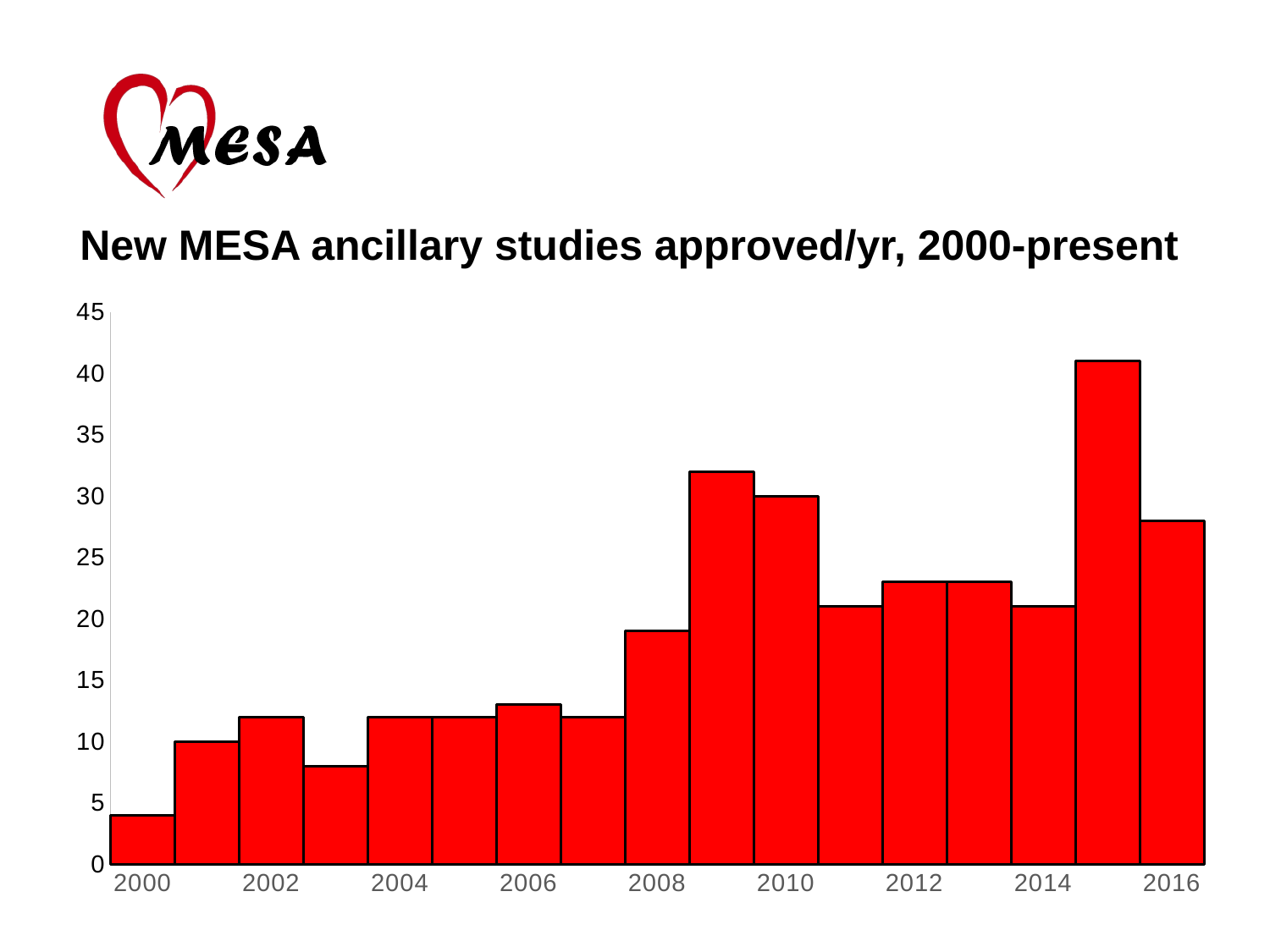
Which year has the highest number of new ancillary studies approved? 2015 What kind of chart is shown on the slide? Bar chart Is the value for 2000 greater or less than 5? less Is the value for 2009 greater or less than 30? greater Is the value for 2016 greater or less than 25? greater What is the title of the chart? New MESA ancillary studies approved/yr, 2000-present Which year has the lowest number of new ancillary studies approved? 2000 How many years (bars) are shown in the chart? 17 Overall, do the number of new ancillary studies approved per year rise or fall from 2000 to 2016? Rise Which year has more new ancillary studies approved, 2009 or 2016? 2009